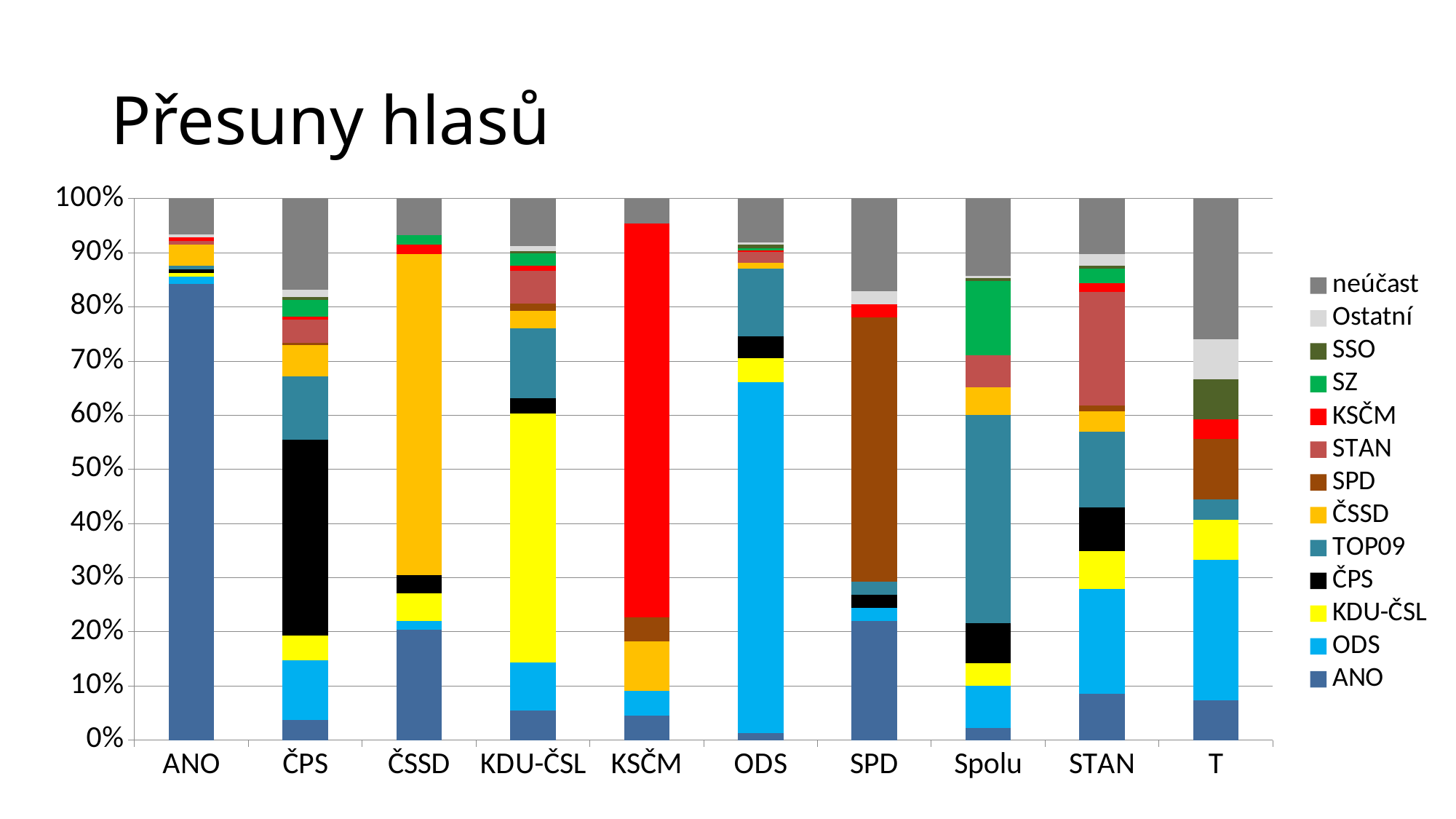
What is the title of the chart? Přesuny hlasů Which bar has the largest neúčast segment? T Is the KDU-ČSL segment in the KDU-ČSL bar greater or less than 50%? less What type of chart is shown on the slide? stacked bar chart What does each stacked bar total on the percentage axis? 100% How many categories are shown along the x axis? 10 How many series does the legend list? 13 Is the KSČM segment in the KSČM bar greater or less than 70%? greater Which is larger: the ANO segment in the ANO bar or the ODS segment in the ODS bar? the ANO segment in the ANO bar Which legend entry is listed first at the top of the legend? neúčast Is the neúčast segment in the ANO bar greater or less than 10%? less